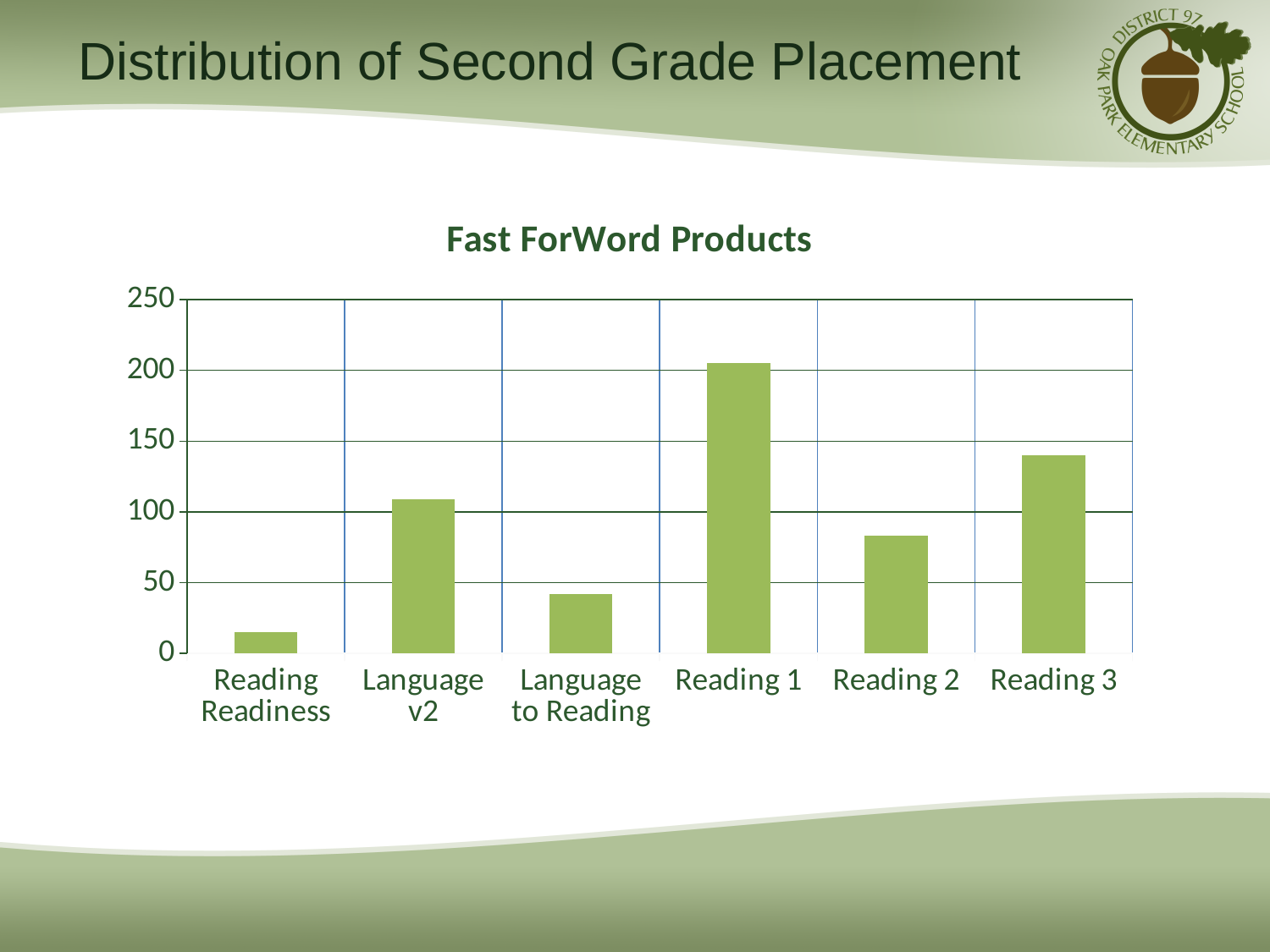
Which is larger, the value for Language v2 or the value for Language to Reading? Language v2 Is the value for Reading Readiness greater or less than 50? less Is the value for Language to Reading greater or less than 50? less Which product has the lowest bar? Reading Readiness Is the value for Reading 3 greater or less than 100? greater What is the title of the chart? Fast ForWord Products Which product has the highest bar? Reading 1 Which is larger, the value for Reading 3 or the value for Reading 2? Reading 3 How many product categories are shown on the x axis? 6 What kind of chart is shown on the slide? bar chart